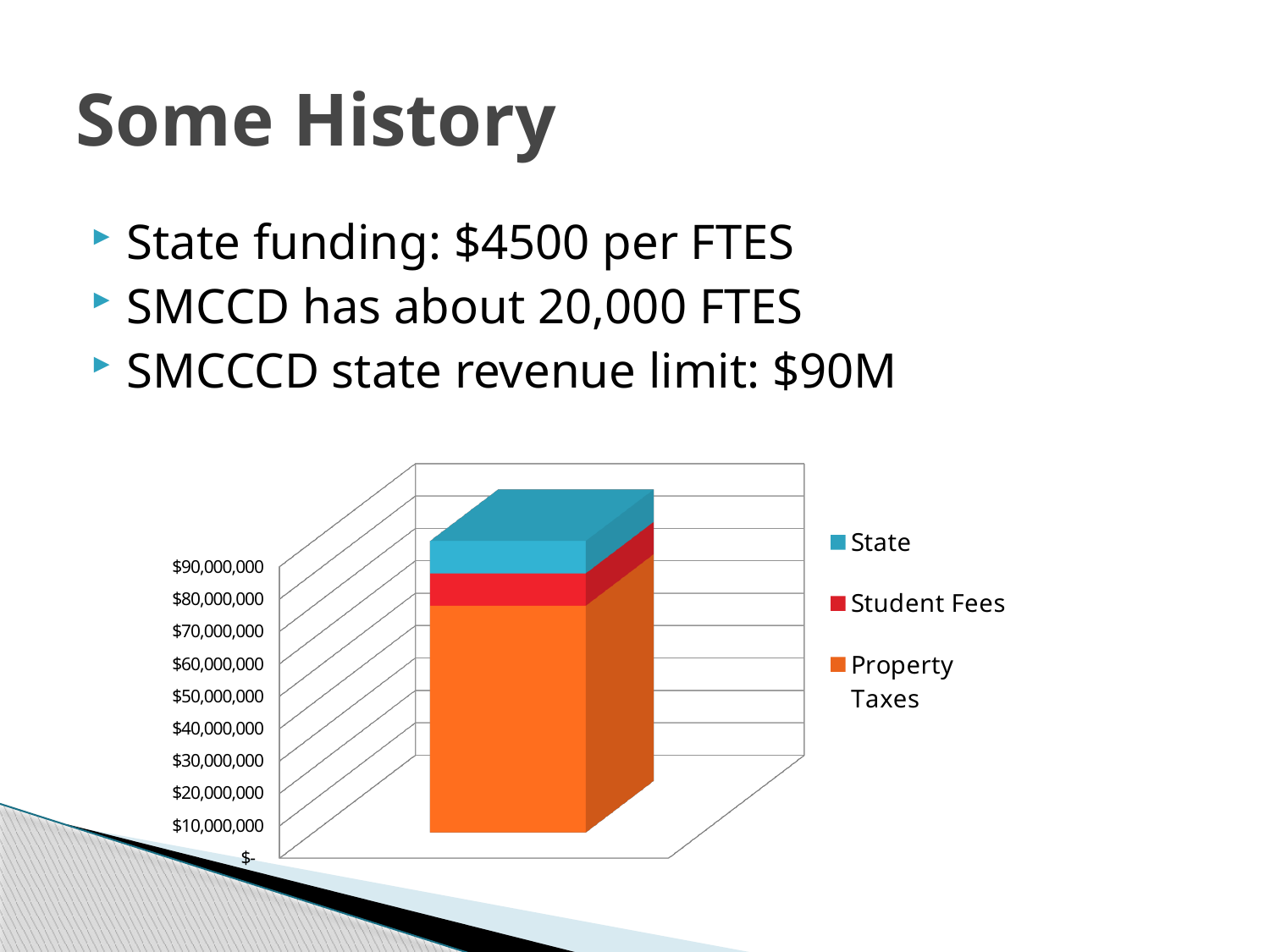
Which is larger in the stacked bar, the Property Taxes segment or the State segment? Property Taxes Is the value of the Student Fees segment greater or less than $30,000,000? less Is the value of the Property Taxes segment greater or less than $50,000,000? greater Which is larger in the stacked bar, the Property Taxes segment or the Student Fees segment? Property Taxes How many series does the chart's legend list? 3 Is the value of the State segment greater or less than $30,000,000? less What is the highest value labelled on the chart's vertical axis? $90,000,000 Which series makes up the largest segment of the stacked bar? Property Taxes What kind of chart is shown on the slide? stacked bar chart How many bars are plotted in the chart? 1 What colour represents Property Taxes in the chart's legend? orange